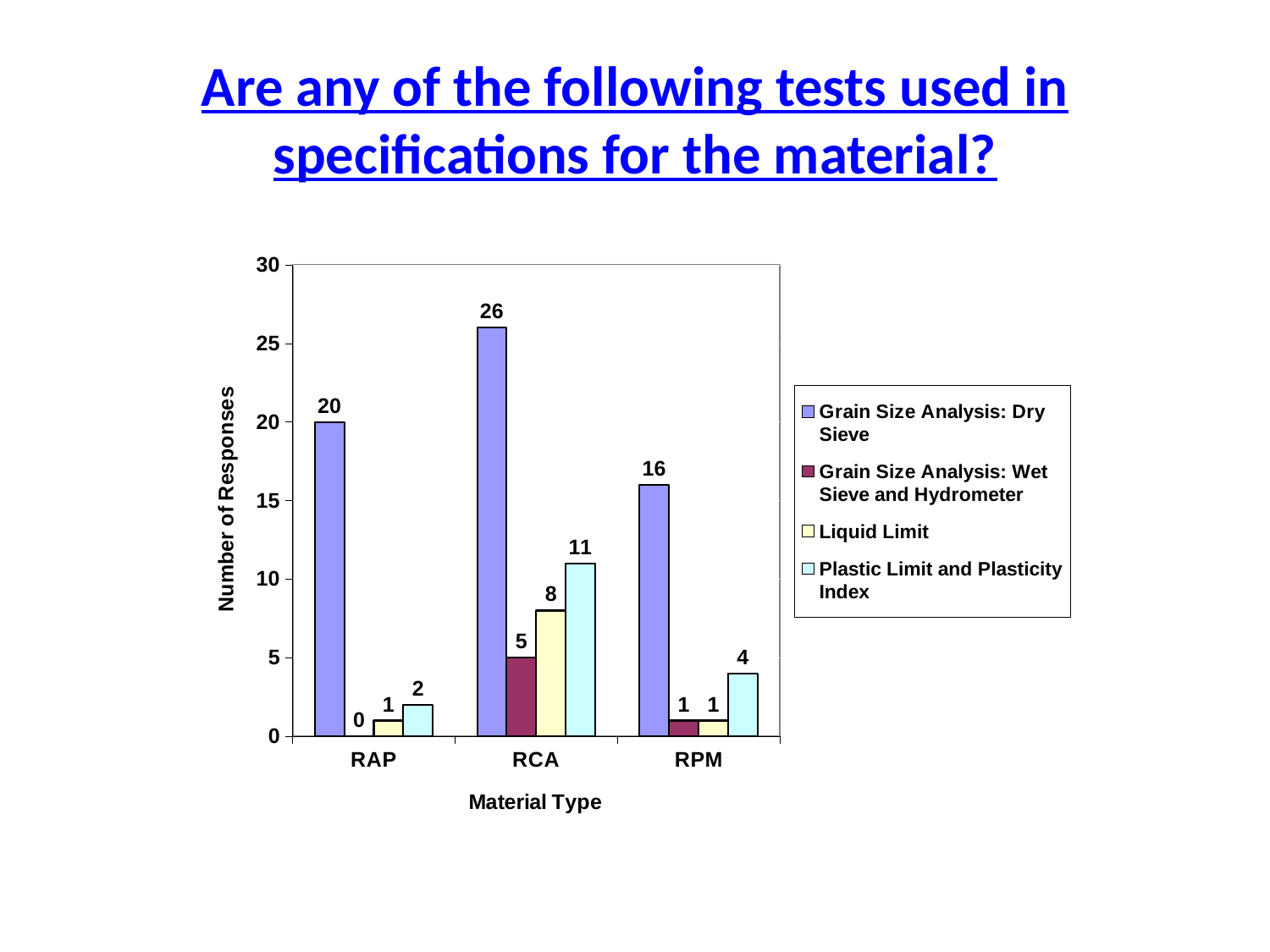
How many series does the legend list? 4 Which material type has the highest number of responses for Grain Size Analysis: Dry Sieve? RCA What is the number of responses for Liquid Limit for RAP? 1 What is the number of responses for Grain Size Analysis: Wet Sieve and Hydrometer for RAP? 0 Which is larger for RCA: Liquid Limit or Plastic Limit and Plasticity Index? Plastic Limit and Plasticity Index What is the label of the y axis? Number of Responses What is the number of responses for Plastic Limit and Plasticity Index for RPM? 4 What kind of chart is shown on the slide? Bar chart What is the number of responses for Grain Size Analysis: Dry Sieve for RCA? 26 What is the difference between the Grain Size Analysis: Dry Sieve responses for RCA and RPM? 10 How many material types are shown on the x axis? 3 Which material type has the lowest number of responses for Plastic Limit and Plasticity Index? RAP